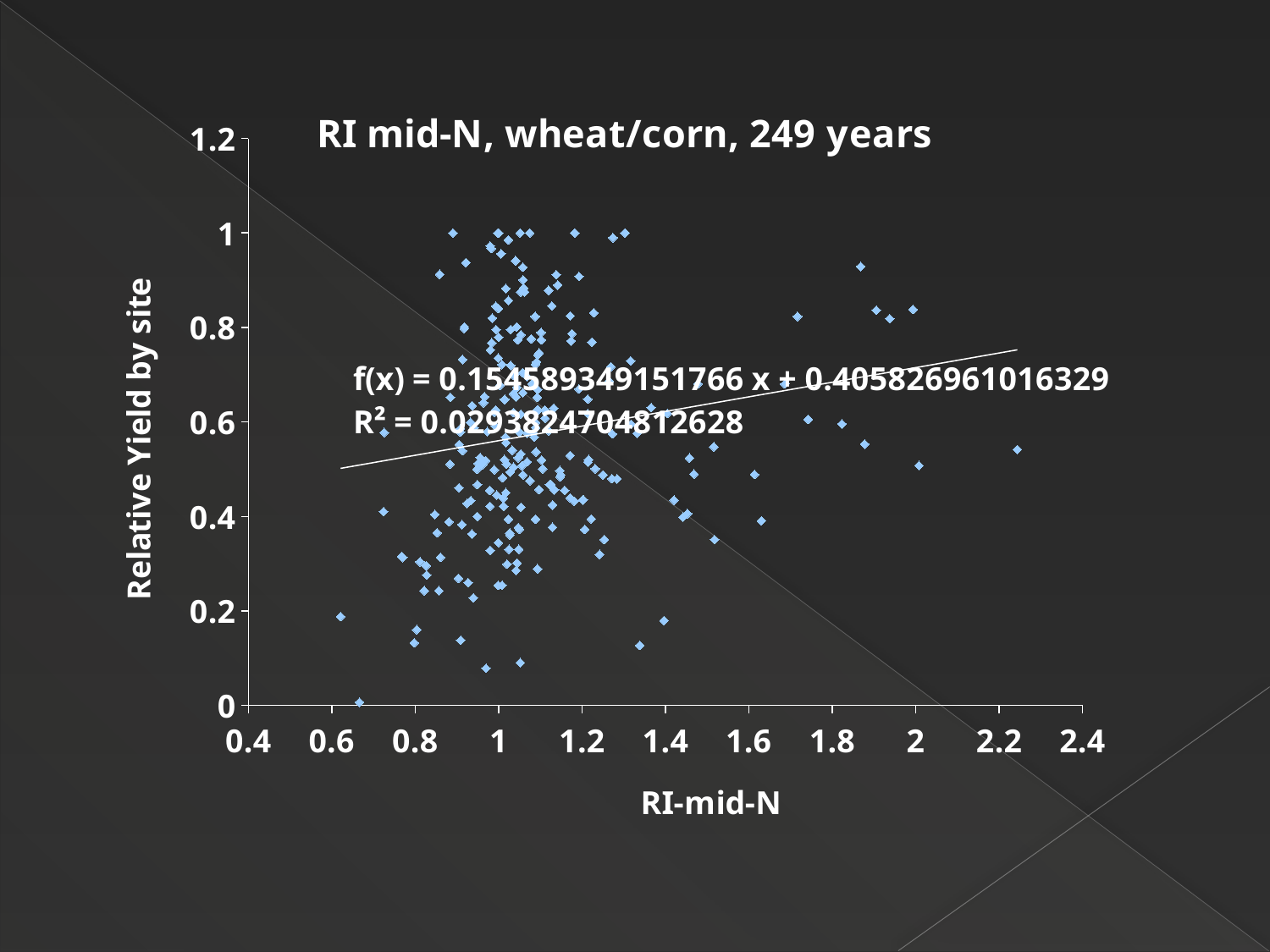
What is the title of the chart? RI mid-N, wheat/corn, 249 years Is the R² value printed on the chart greater or less than 0.2? less What R² value is printed on the chart? 0.0293824704812628 What is the lowest value shown on the x axis? 0.4 What kind of chart is shown on the slide? scatter plot What is the slope of the fitted line f(x) printed on the chart? 0.154589349151766 Is the slope of the fitted line greater or less than 0? greater What is the highest value shown on the y axis? 1.2 Does the fitted trendline rise or fall as RI-mid-N increases? rise What is the label of the y axis? Relative Yield by site What is the intercept of the fitted line f(x) printed on the chart? 0.405826961016329